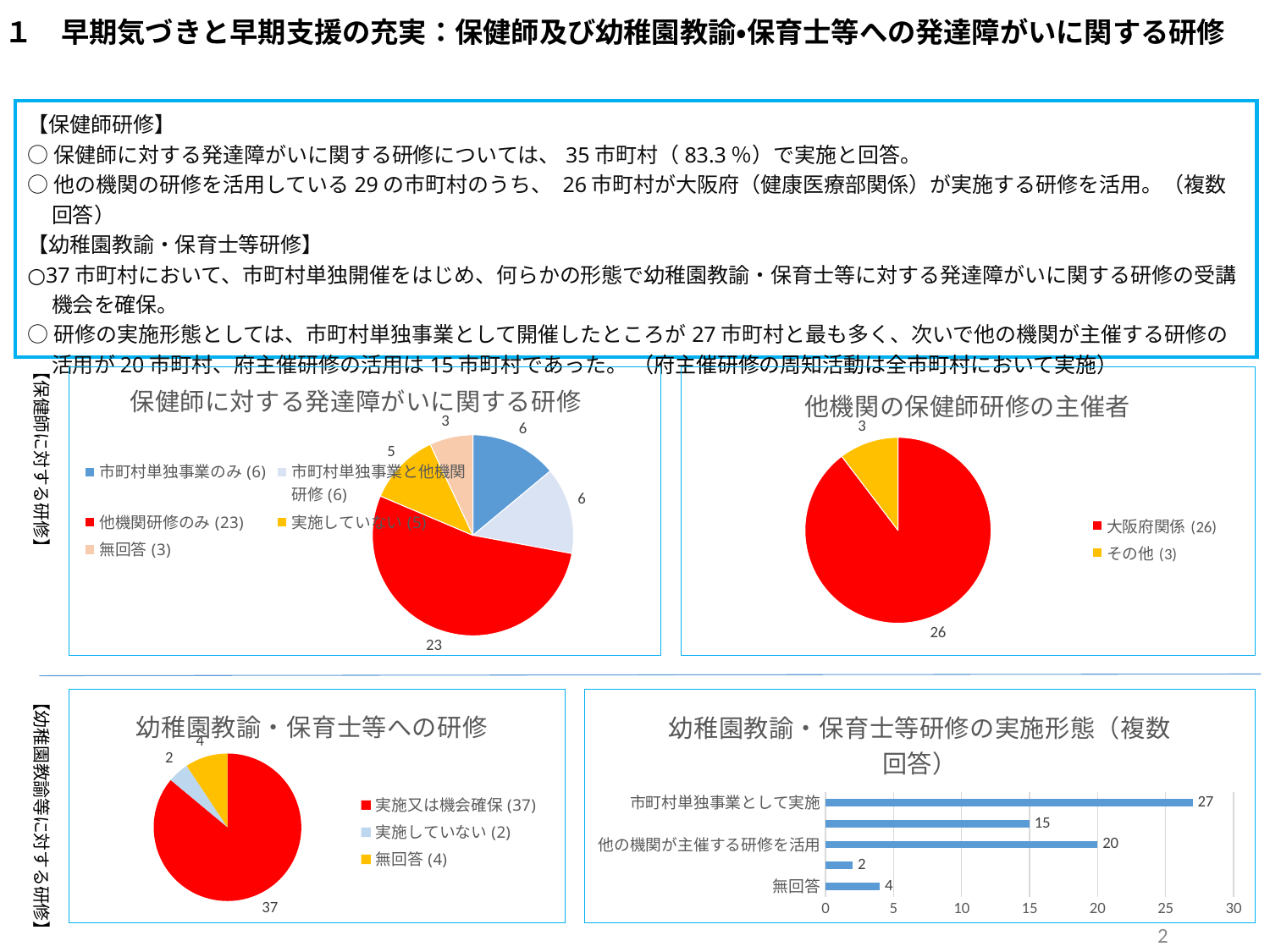
In the chart titled 「保健師に対する発達障がいに関する研修」, what is the value for 他機関研修のみ? 23 In the chart titled 「保健師に対する発達障がいに関する研修」, which category has the largest slice? 他機関研修のみ In the chart titled 「他機関の保健師研修の主催者」, what is the value for 大阪府関係? 26 In the chart titled 「保健師に対する発達障がいに関する研修」, which category has the smallest slice? 無回答 What kind of chart is the one titled 「幼稚園教諭・保育士等研修の実施形態（複数回答）」? bar chart How many categories does the legend of the chart titled 「保健師に対する発達障がいに関する研修」 list? 5 In the chart titled 「幼稚園教諭・保育士等研修の実施形態（複数回答）」, what is the value for 他の機関が主催する研修を活用? 20 In the chart titled 「幼稚園教諭・保育士等研修の実施形態（複数回答）」, what is the difference between 市町村単独事業として実施 and 無回答? 23 In the chart titled 「他機関の保健師研修の主催者」, what is the difference between 大阪府関係 and その他? 23 What kind of chart is the one titled 「他機関の保健師研修の主催者」? pie chart In the chart titled 「幼稚園教諭・保育士等への研修」, which is larger, 実施していない or 無回答? 無回答 In the chart titled 「幼稚園教諭・保育士等への研修」, what is the value for 実施又は機会確保? 37